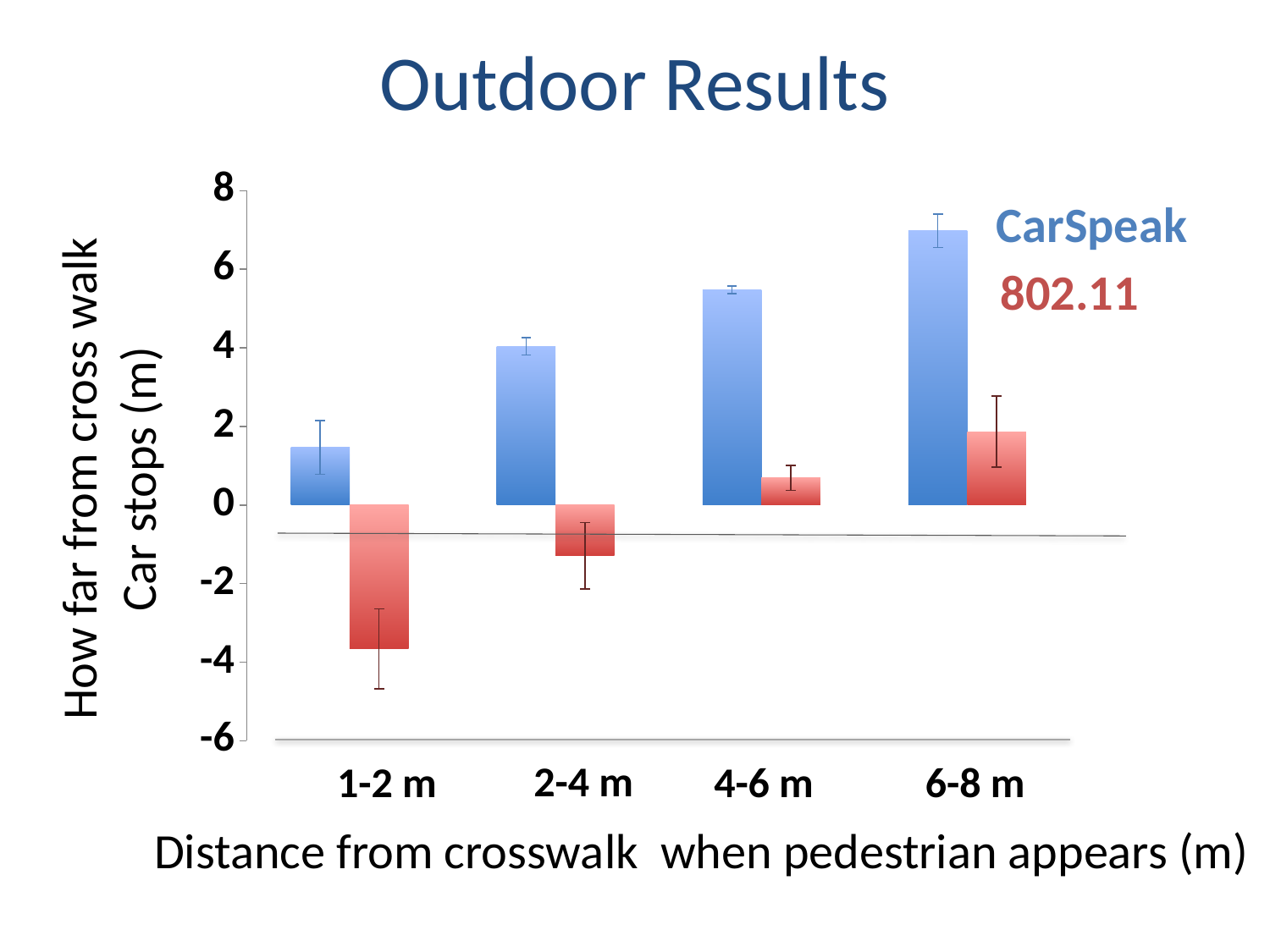
For which distance category is the 802.11 value lowest? 1-2 m At 4-6 m, which series has the larger value, CarSpeak or 802.11? CarSpeak How many series does the legend list? 2 For which distance category is the CarSpeak value highest? 6-8 m What kind of chart is shown on the slide? bar chart Do the CarSpeak values rise or fall as the distance from the crosswalk increases? rise How many distance categories are shown on the x axis? 4 What is the title of the slide? Outdoor Results Is the CarSpeak value for 6-8 m greater or less than 6? greater Is the CarSpeak value for 1-2 m greater or less than 2? less Is the 802.11 value for 2-4 m greater or less than 0? less